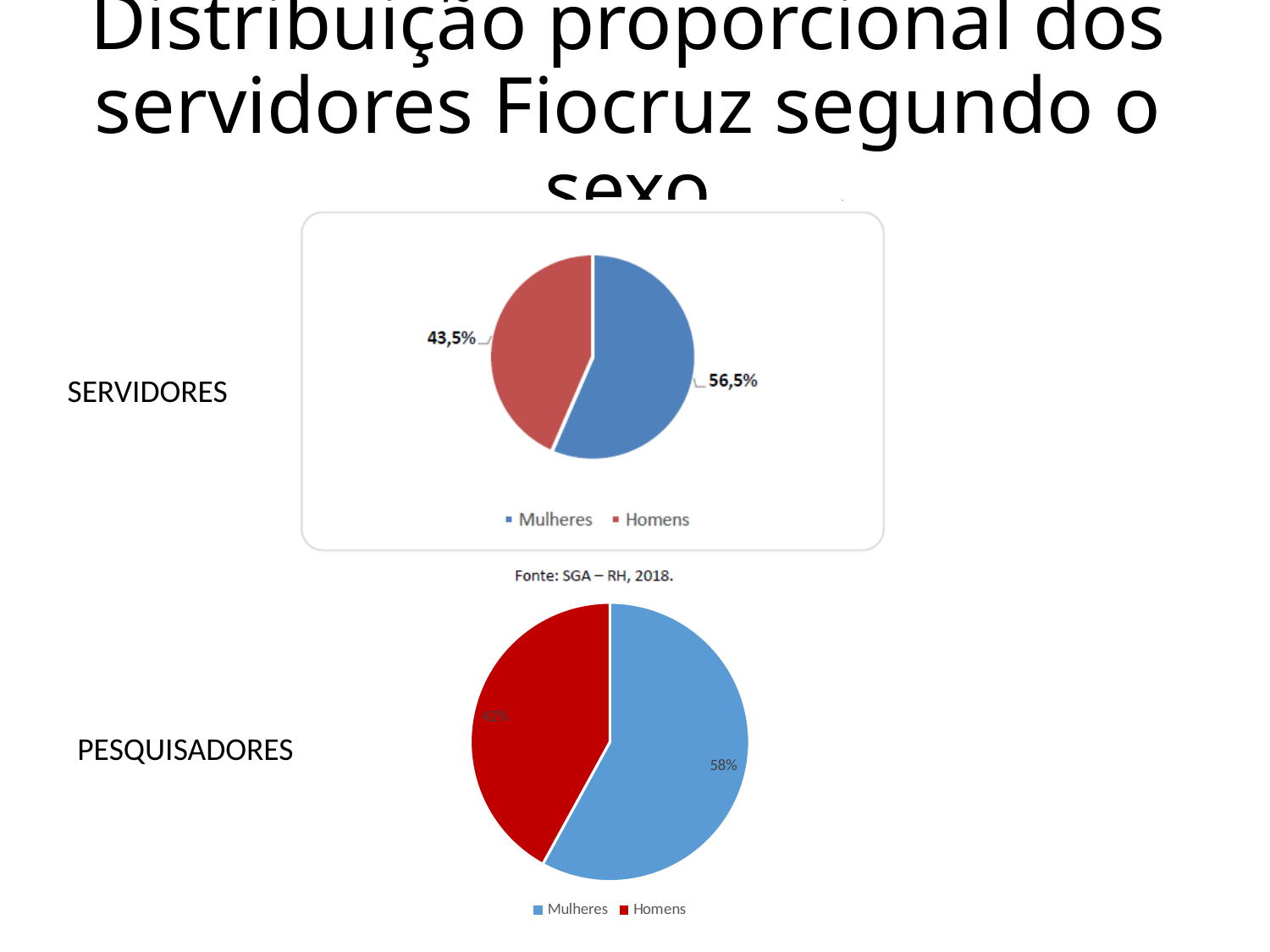
In the SERVIDORES chart, what share of the pie is Mulheres? 56,5% How many slices does the PESQUISADORES pie chart have? 2 What kind of chart is the SERVIDORES chart? Pie chart What source is cited below the SERVIDORES chart? Fonte: SGA – RH, 2018. In the SERVIDORES chart, which category has the smaller share? Homens In the SERVIDORES chart, what is the difference in percentage points between Mulheres and Homens? 13 percentage points In the PESQUISADORES chart, is the share for Mulheres greater or less than 50%? greater In the SERVIDORES chart, what share of the pie is Homens? 43,5% In the PESQUISADORES chart, what share of the pie is Mulheres? 58% How many entries does the legend of the SERVIDORES chart list? 2 In the SERVIDORES chart, which category has the larger share? Mulheres In the PESQUISADORES chart, which is larger, Mulheres or Homens? Mulheres